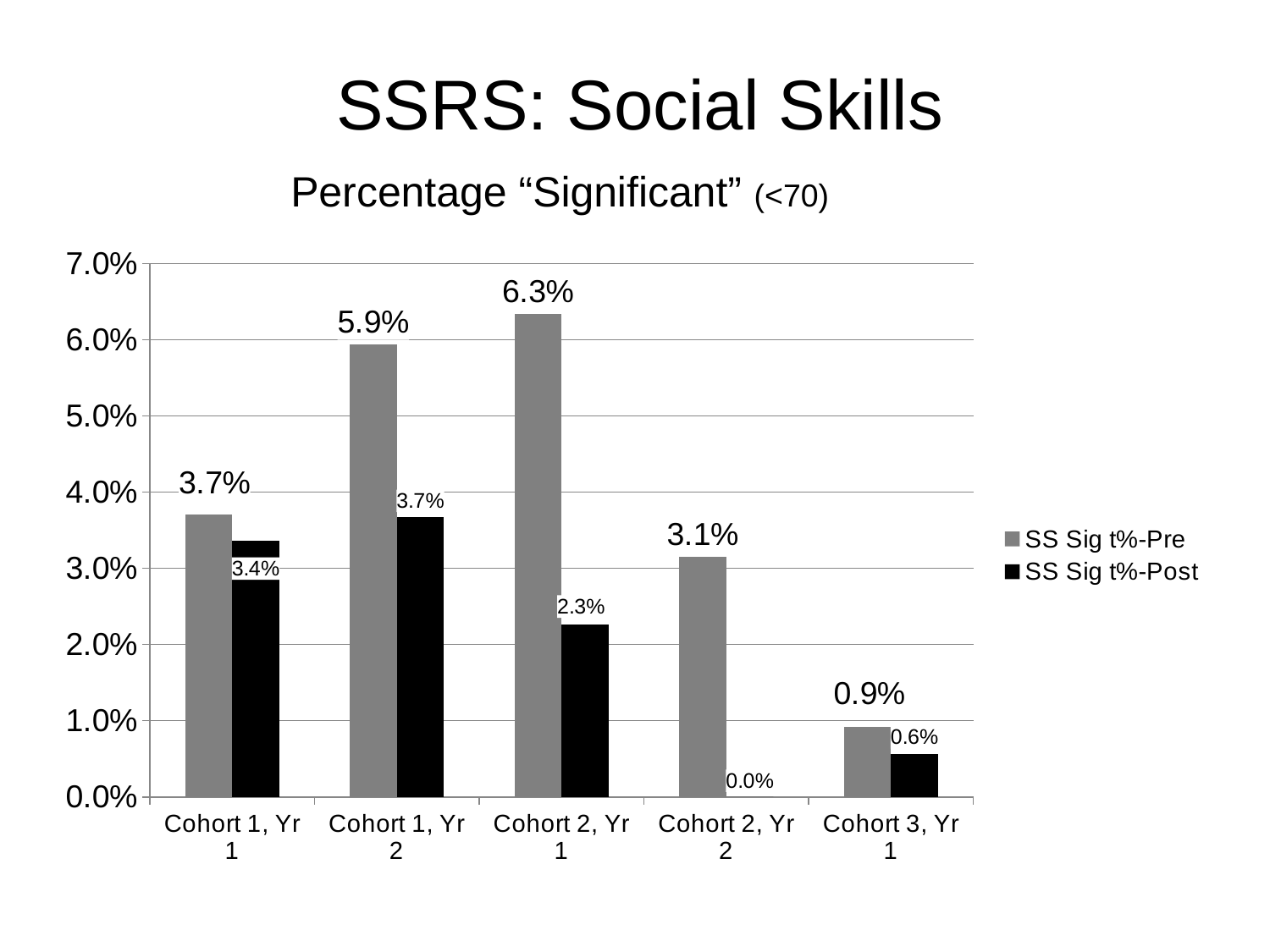
How many series does the legend list? 2 Which colour represents the SS Sig t%-Post series? Black Which cohort has the lowest SS Sig t%-Pre value? Cohort 3, Yr 1 What is the difference between the SS Sig t%-Pre and SS Sig t%-Post values for Cohort 2, Yr 1? 4.0% Which is larger for Cohort 1, Yr 1: the SS Sig t%-Pre value or the SS Sig t%-Post value? SS Sig t%-Pre What is the SS Sig t%-Pre value for Cohort 2, Yr 1? 6.3% What kind of chart is shown on the slide? Bar chart Which cohort has the highest SS Sig t%-Pre value? Cohort 2, Yr 1 How many cohort categories are shown on the x axis? 5 What is the SS Sig t%-Post value for Cohort 2, Yr 2? 0.0% What is the SS Sig t%-Post value for Cohort 1, Yr 2? 3.7% Is the SS Sig t%-Pre value for Cohort 1, Yr 2 greater or less than 5.0%? greater